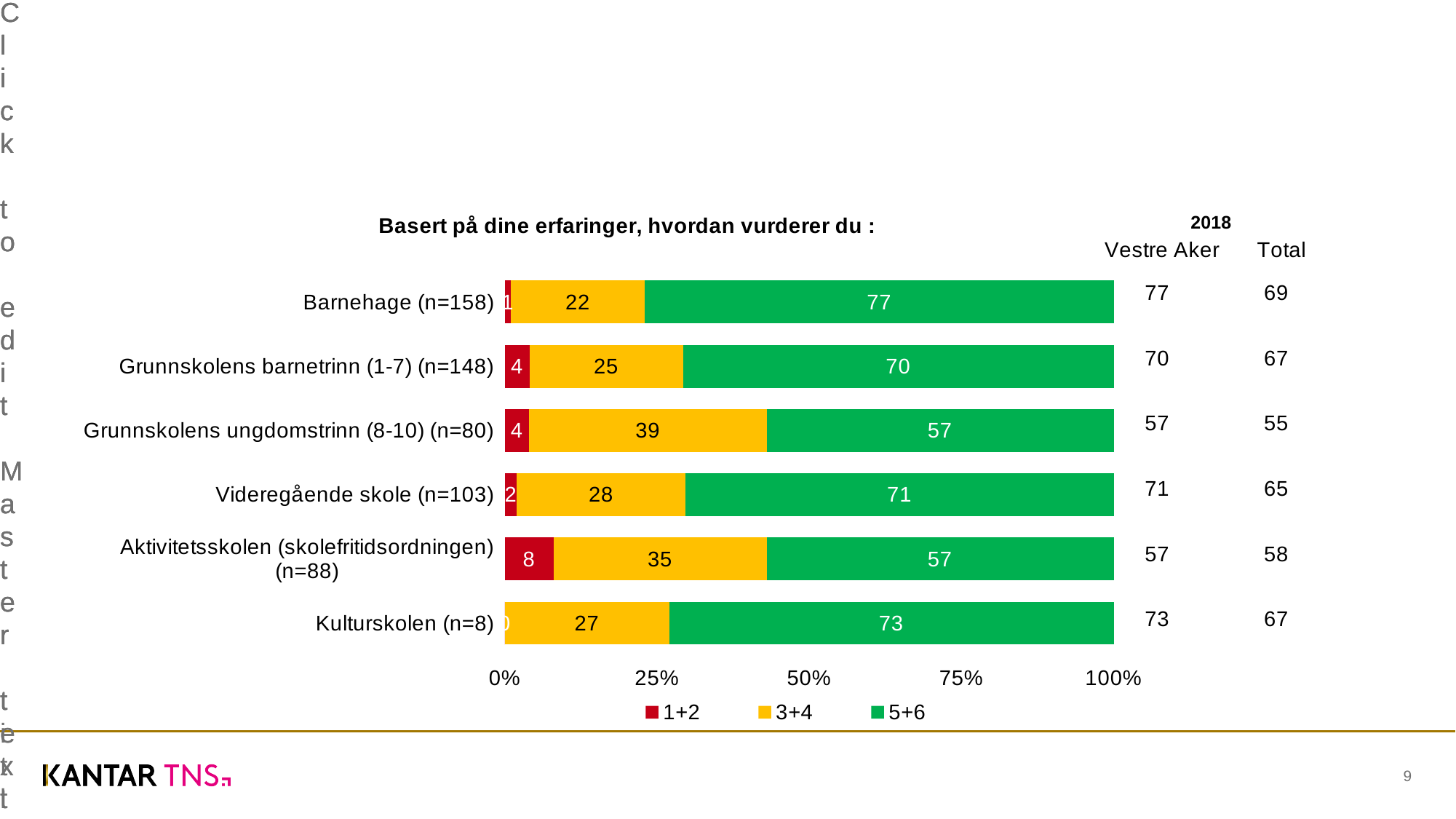
How many categories are shown in the chart? 6 Which has a larger 3+4 value: Aktivitetsskolen (skolefritidsordningen) (n=88) or Videregående skole (n=103)? Aktivitetsskolen (skolefritidsordningen) (n=88) What is the value of the 3+4 series for Grunnskolens ungdomstrinn (8-10) (n=80)? 39 Which category has the highest value for the 1+2 series? Aktivitetsskolen (skolefritidsordningen) (n=88) How many series does the legend list? 3 What is the value of the 1+2 series for Aktivitetsskolen (skolefritidsordningen) (n=88)? 8 What kind of chart is shown on the slide? Stacked bar chart Which category has the highest value for the 5+6 series? Barnehage (n=158) Which category has the highest value for the 3+4 series? Grunnskolens ungdomstrinn (8-10) (n=80) What is the difference between the 5+6 values for Barnehage (n=158) and Videregående skole (n=103)? 6 What is the total of the stacked bar for Grunnskolens ungdomstrinn (8-10) (n=80)? 100 What is the value of the 5+6 series for Barnehage (n=158)? 77